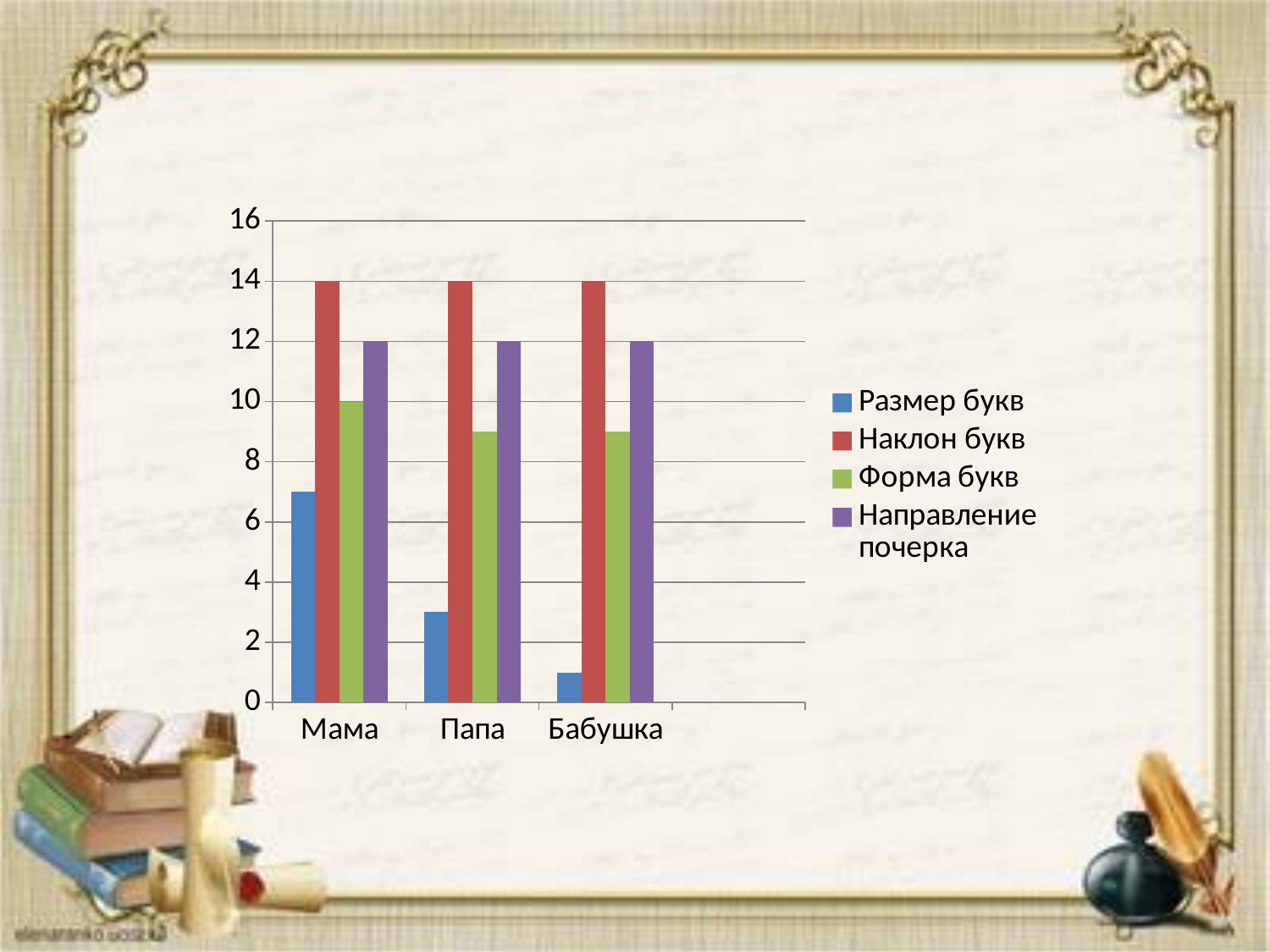
How many categories are shown on the x axis of the chart? 3 Which is larger: Размер букв for Мама or Размер букв for Папа? Мама How many series does the chart's legend list? 4 Do the values of Размер букв rise or fall from Мама to Бабушка along the x axis? fall What is the value of Направление почерка for Папа? 12 What is the value of Форма букв for Мама? 10 What is the value of Наклон букв for Мама? 14 Is the value of Размер букв for Мама greater or less than 6? greater Which category has the lowest value for Размер букв? Бабушка What is the difference between Наклон букв and Направление почерка for Мама? 2 What kind of chart is shown on the slide? bar chart Is the value of Размер букв for Бабушка greater or less than 2? less